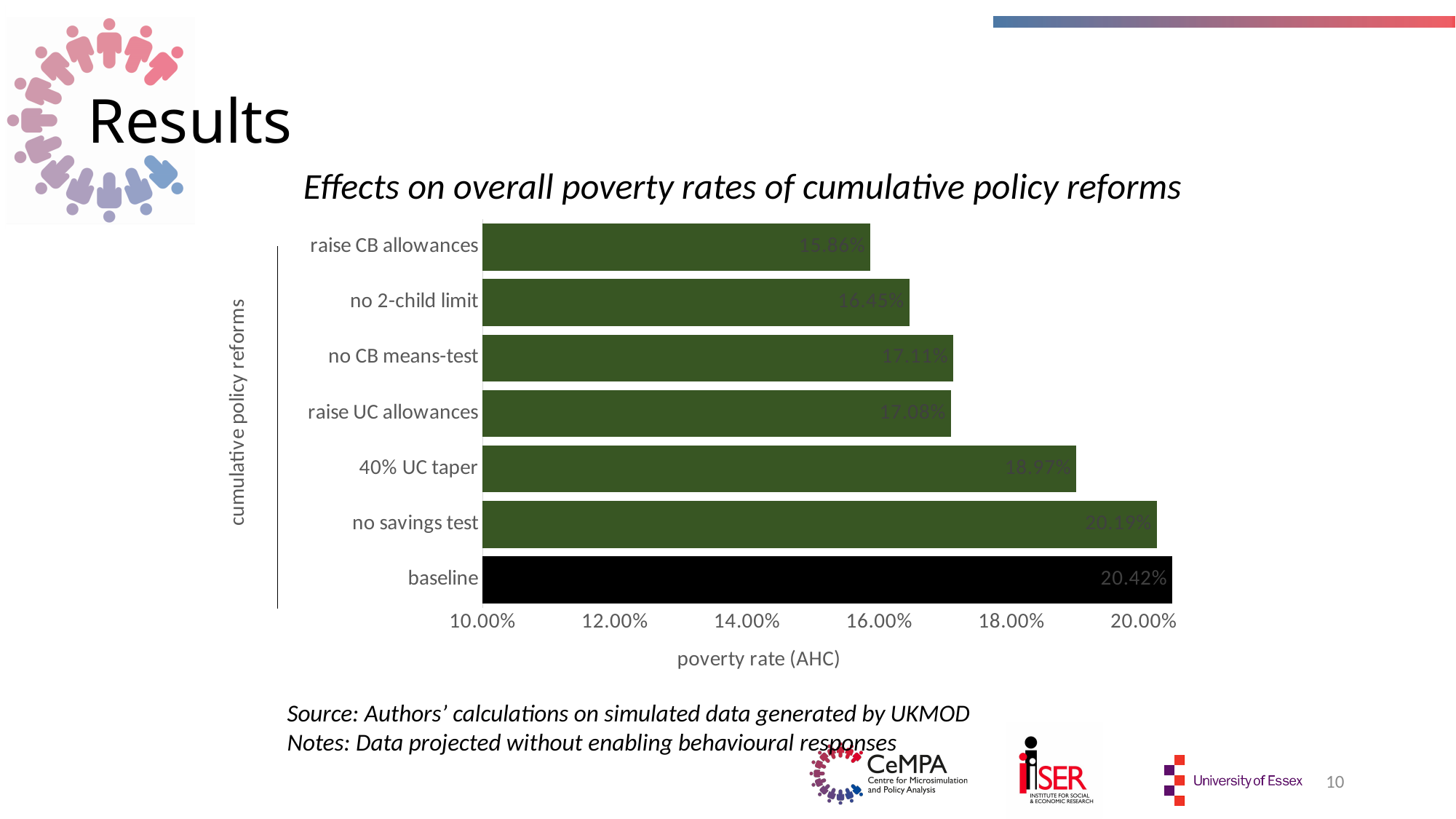
Which has a higher poverty rate: 'no savings test' or 'no 2-child limit'? no savings test What is the label of the horizontal axis of the chart? poverty rate (AHC) Which category has the lowest poverty rate? raise CB allowances What is the poverty rate (AHC) after the 'raise CB allowances' reform? 15.86% What is the poverty rate (AHC) for the 'no 2-child limit' reform? 16.45% What type of chart is shown on the slide? bar chart What is the difference in poverty rate between 'no savings test' and '40% UC taper'? 1.22% Which category has the highest poverty rate? baseline What is the poverty rate (AHC) for the '40% UC taper' reform? 18.97% How many cumulative policy reform categories are shown in the chart? 7 What is the difference in poverty rate between the baseline and the 'raise CB allowances' reform? 4.56% What is the poverty rate (AHC) for the baseline? 20.42%